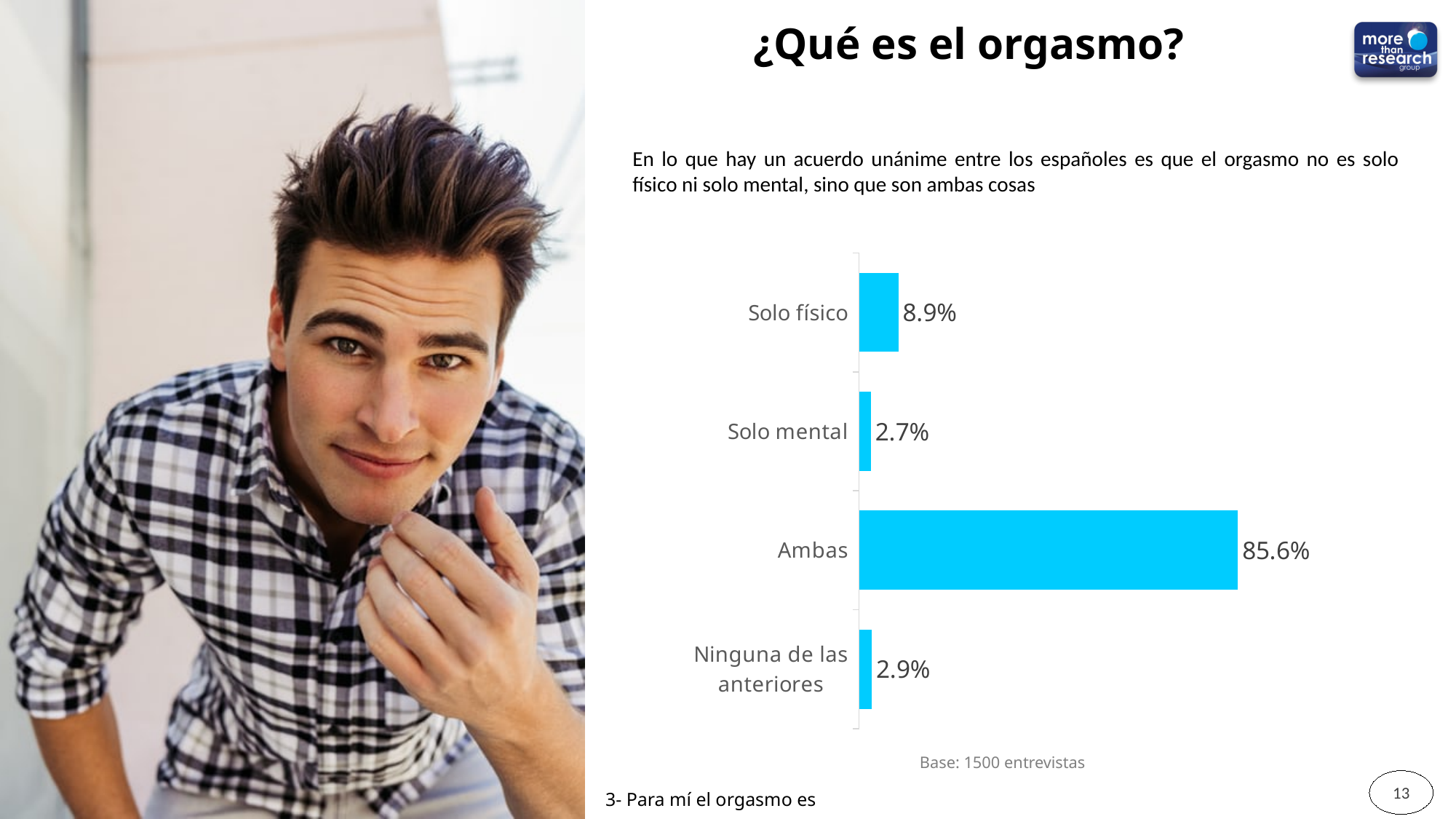
What is the value for Solo físico? 8.9% What is the value for Solo mental? 2.7% What is the value for Ambas? 85.6% Which is larger, the value for Solo físico or the value for Solo mental? Solo físico How many categories are shown in the chart? 4 What is the difference between the values for Ninguna de las anteriores and Solo mental? 0.2% What base (number of interviews) is stated below the chart? 1500 entrevistas What is the value for Ninguna de las anteriores? 2.9% What is the difference between the values for Ambas and Solo físico? 76.7% Which category has the lowest value? Solo mental Which category has the highest value? Ambas What kind of chart is shown on the slide? Bar chart